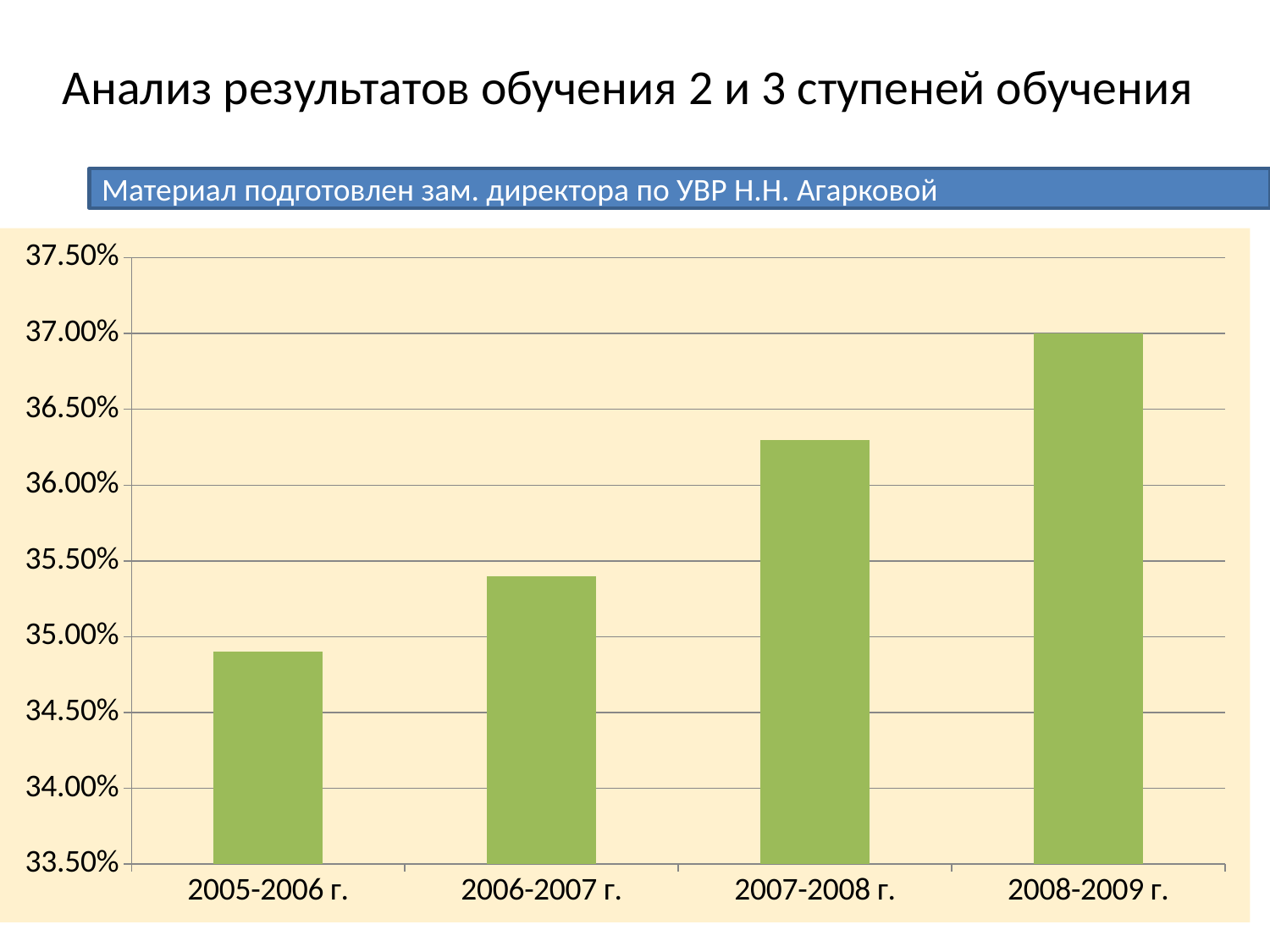
Do the values rise or fall from 2005-2006 г. to 2008-2009 г.? rise What is the title of the slide containing the chart? Анализ результатов обучения 2 и 3 ступеней обучения Is the value for 2007-2008 г. greater or less than 36.50%? less Is the value for 2006-2007 г. greater or less than 35.50%? less Which is larger, the value for 2007-2008 г. or the value for 2006-2007 г.? 2007-2008 г. Which school year has the lowest value in the chart? 2005-2006 г. Which school year has the highest value in the chart? 2008-2009 г. Is the value for 2005-2006 г. greater or less than 35.00%? less How many school years (categories) are shown on the x axis of the chart? 4 What kind of chart is shown on the slide? bar chart